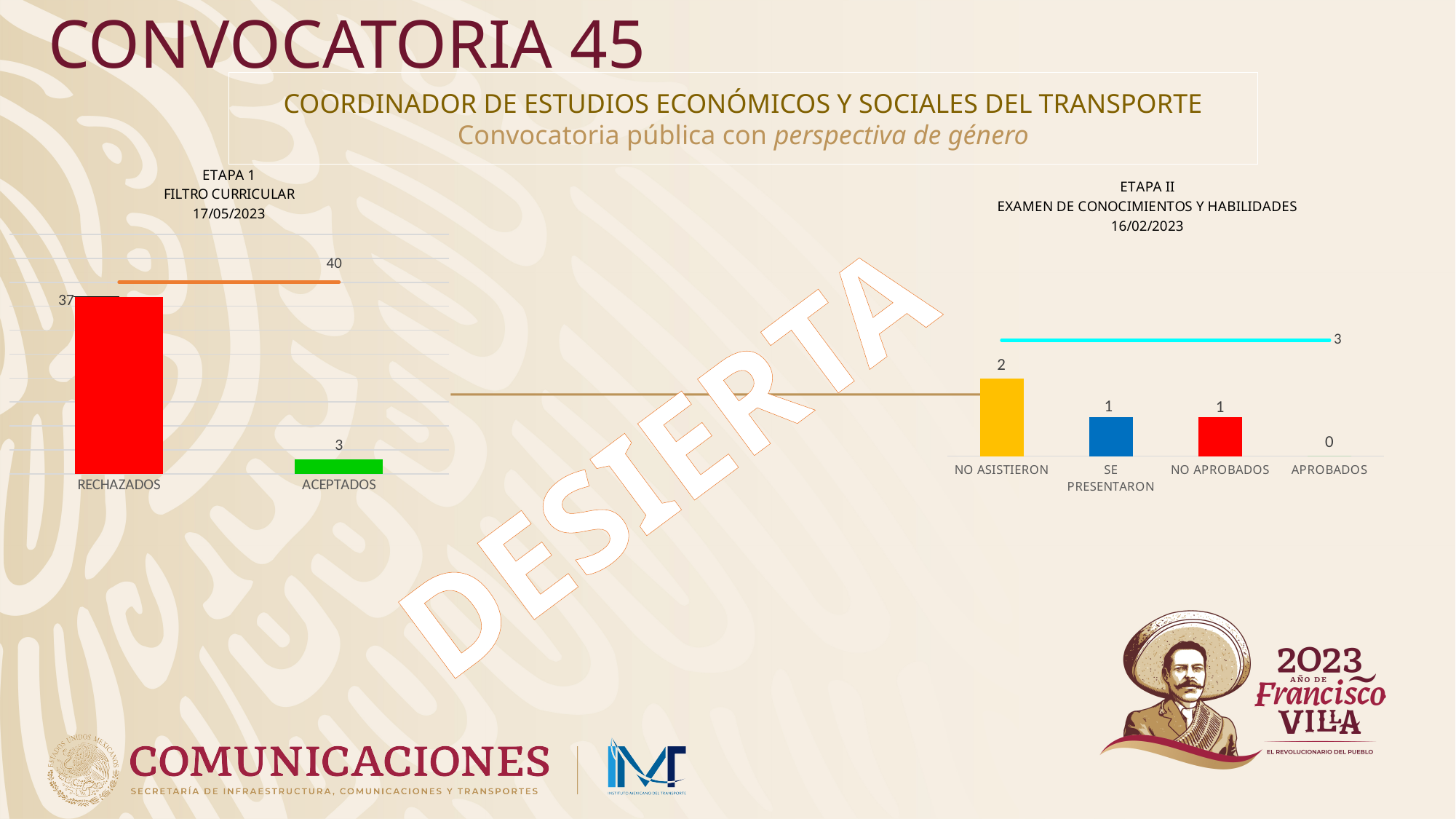
In the ETAPA II EXAMEN DE CONOCIMIENTOS Y HABILIDADES chart, what value is labelled on the cyan line? 3 In the ETAPA II EXAMEN DE CONOCIMIENTOS Y HABILIDADES chart, how many categories are shown on the x axis? 4 In the ETAPA 1 FILTRO CURRICULAR chart, what is the value for RECHAZADOS? 37 In the ETAPA 1 FILTRO CURRICULAR chart, what is the difference between RECHAZADOS and ACEPTADOS? 34 In the ETAPA II EXAMEN DE CONOCIMIENTOS Y HABILIDADES chart, what is the value for APROBADOS? 0 In the ETAPA 1 FILTRO CURRICULAR chart, what is the value for ACEPTADOS? 3 In the ETAPA 1 FILTRO CURRICULAR chart, which category has the highest value? RECHAZADOS In the ETAPA II EXAMEN DE CONOCIMIENTOS Y HABILIDADES chart, what is the value for SE PRESENTARON? 1 In the ETAPA II EXAMEN DE CONOCIMIENTOS Y HABILIDADES chart, what is the value for NO ASISTIERON? 2 What kind of chart is the ETAPA 1 FILTRO CURRICULAR chart? Combination bar and line chart In the ETAPA II EXAMEN DE CONOCIMIENTOS Y HABILIDADES chart, which category has the lowest value? APROBADOS In the ETAPA 1 FILTRO CURRICULAR chart, what value is labelled on the orange line? 40